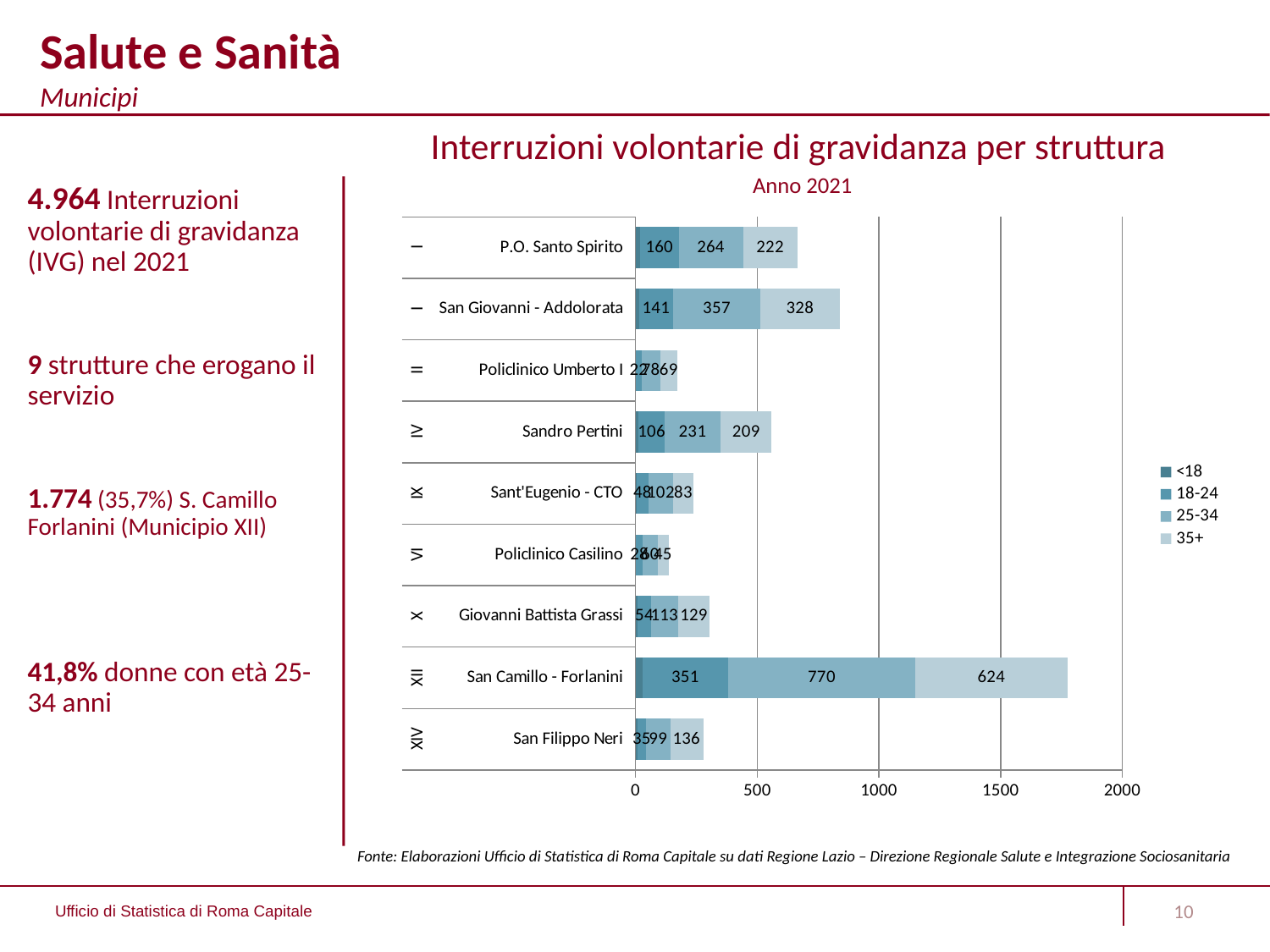
How many series does the legend list? 4 What is the value for the 25-34 age group at San Camillo - Forlanini? 770 What kind of chart is shown on the slide? bar chart What is the value for the 18-24 age group at P.O. Santo Spirito? 160 How many structures (categories) are plotted in the chart? 9 Which has the larger 25-34 value: Sandro Pertini or P.O. Santo Spirito? P.O. Santo Spirito What is the value for the 35+ age group at Sandro Pertini? 209 What is the value for the 35+ age group at San Giovanni - Addolorata? 328 Is the total bar length for San Camillo - Forlanini greater or less than 1500? greater Which structure has the longest bar overall? San Camillo - Forlanini What is the difference between the 25-34 value and the 35+ value at San Camillo - Forlanini? 146 What are the four legend entries of the chart? <18, 18-24, 25-34, 35+